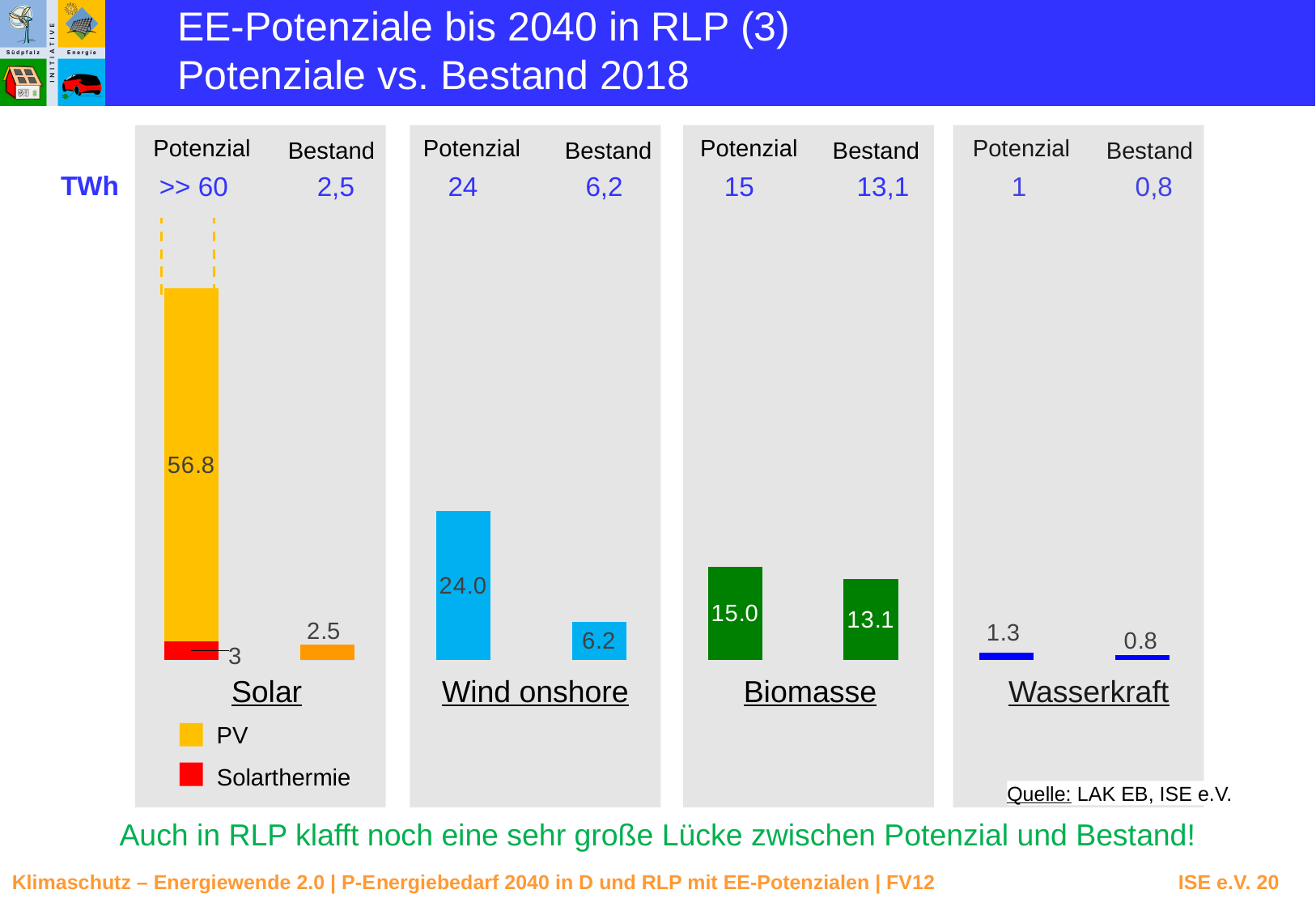
What is the difference between the Potenzial and Bestand bars for Biomasse? 1.9 What is the data label on the Solarthermie portion of the Solar Potenzial bar? 3 What is the difference between the Potenzial and Bestand bars for Wind onshore? 17.8 What is the data label on the Potenzial bar for Wind onshore? 24.0 What is the data label on the PV portion of the Solar Potenzial bar? 56.8 Which energy source has the lowest Potenzial bar? Wasserkraft What is the data label on the Bestand bar for Biomasse? 13.1 How many energy sources are shown in the chart? 4 Which energy source has the highest Bestand bar? Biomasse What kind of chart is shown on the slide? Bar chart Which is larger, the Bestand bar for Wind onshore or the Bestand bar for Solar? Wind onshore What is the data label on the Bestand bar for Wasserkraft? 0.8